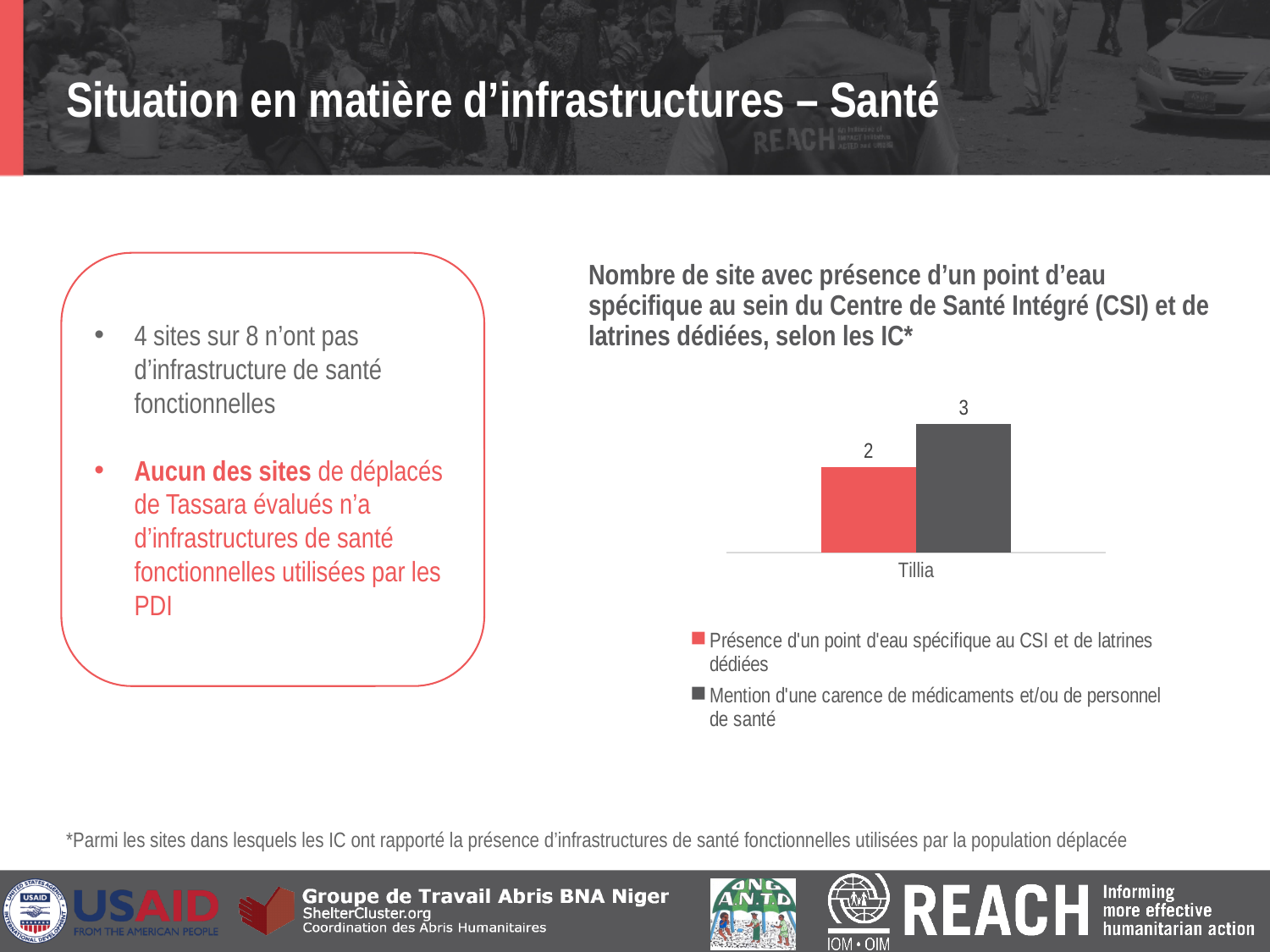
What is the difference between the two bars shown for Tillia? 1 What is the value for 'Mention d'une carence de médicaments et/ou de personnel de santé' in Tillia? 3 What is the only category label on the x axis of the chart? Tillia What is the value for 'Présence d'un point d'eau spécifique au CSI et de latrines dédiées' in Tillia? 2 Is the value for 'Mention d'une carence de médicaments et/ou de personnel de santé' larger or smaller than the value for 'Présence d'un point d'eau spécifique au CSI et de latrines dédiées'? larger How many series does the chart legend list? 2 Which colour represents 'Mention d'une carence de médicaments et/ou de personnel de santé' in the chart? dark grey How many categories are shown on the x axis of the chart? 1 What kind of chart is shown on the slide? bar chart Which series has the lower value for Tillia? Présence d'un point d'eau spécifique au CSI et de latrines dédiées Which series has the higher value for Tillia? Mention d'une carence de médicaments et/ou de personnel de santé